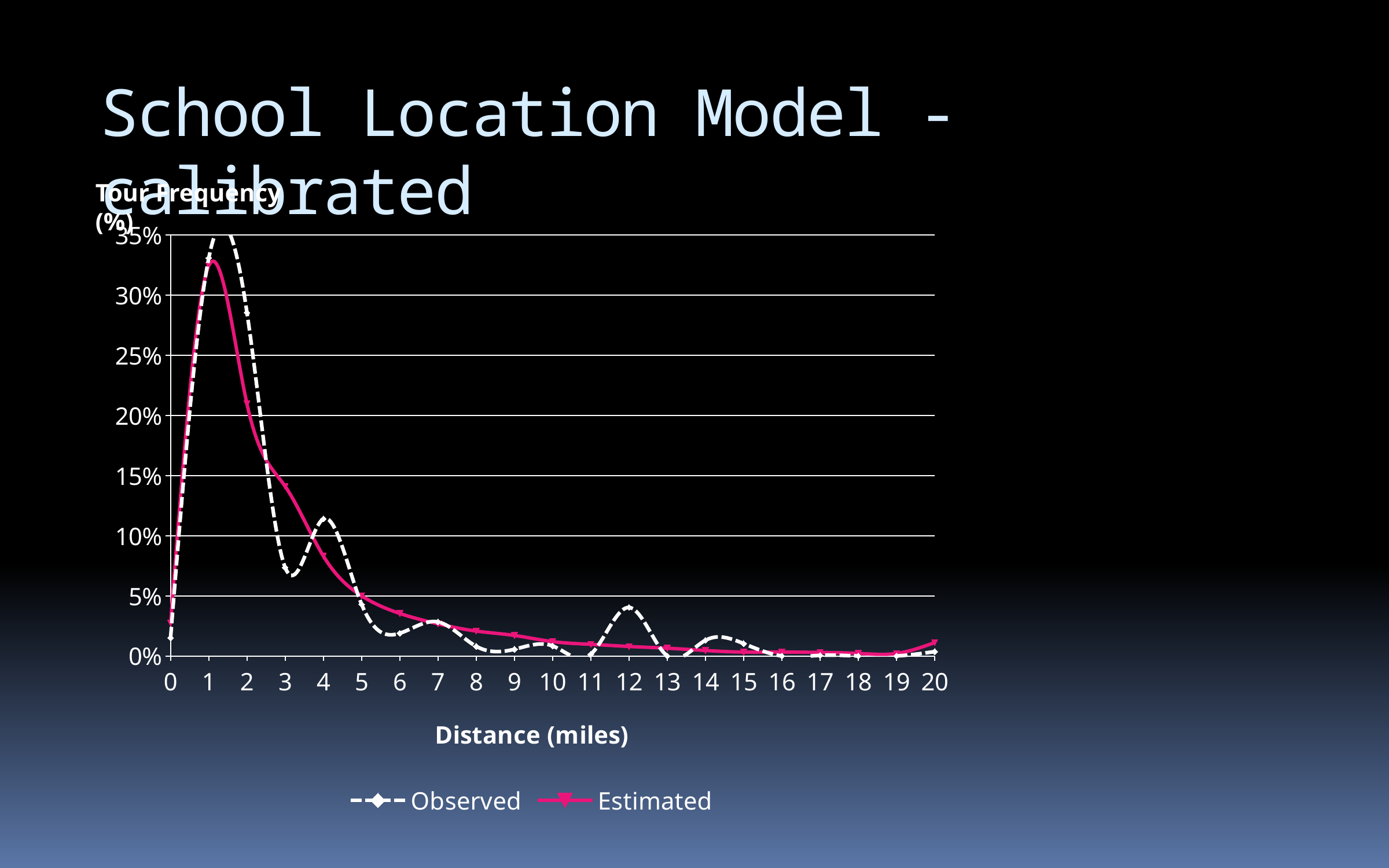
Is the Observed value at 12 miles greater or less than 5%? less At 2 miles, which series has the larger value, Observed or Estimated? Observed Does the Estimated series rise or fall between 1 and 5 miles? fall At which distance does the Observed series reach its highest value? 1 At 3 miles, which series has the larger value, Observed or Estimated? Estimated What is the title of the x axis? Distance (miles) What kind of chart is shown on the slide? line chart Is the Observed value at 3 miles greater or less than 10%? less How many distance points are plotted along the x axis? 21 At which distance does the Estimated series reach its highest value? 1 Is the Estimated value at 1 mile greater or less than 30%? greater How many series does the legend list? 2